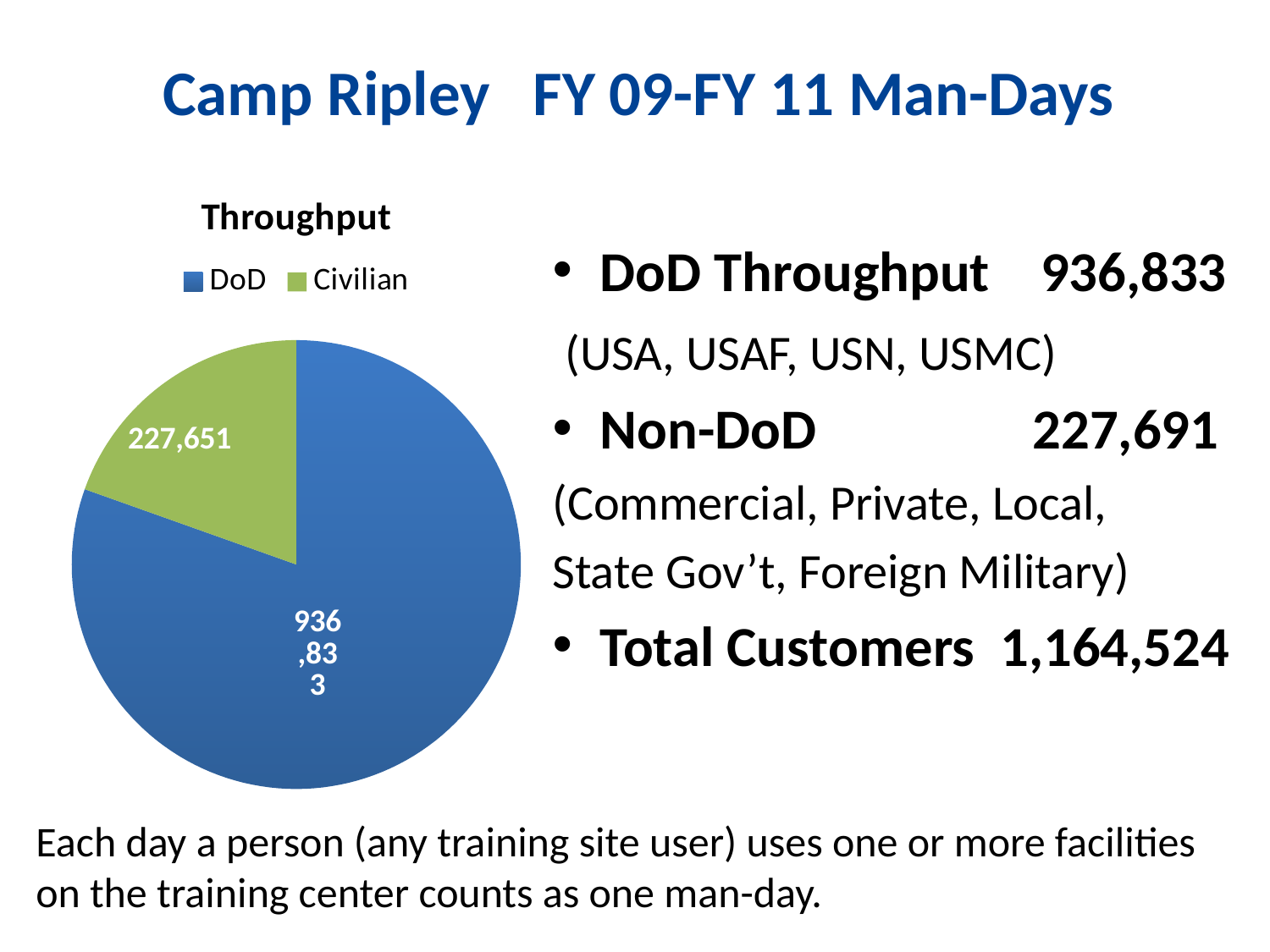
What is the title of the chart? Throughput What kind of chart is shown on the slide? pie chart How many entries does the chart legend list? 2 Which colour represents the Civilian slice in the pie chart? green How many slices does the pie chart have? 2 What is the value of the Civilian slice in the pie chart? 227,651 Which slice of the pie chart is the largest? DoD Which slice of the pie chart is the smallest? Civilian What is the value of the DoD slice in the pie chart? 936,833 Which is larger in the pie chart, DoD or Civilian? DoD